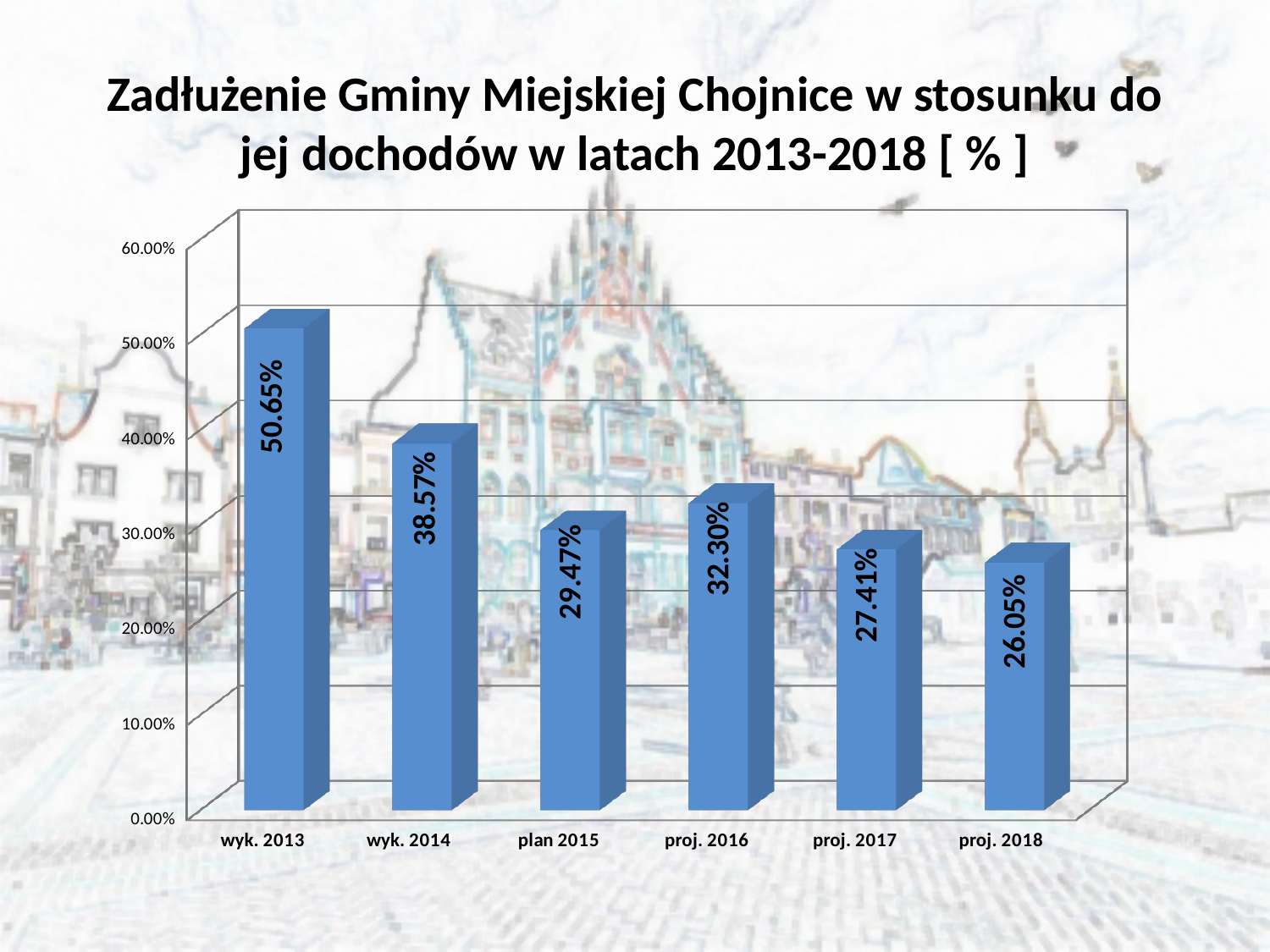
What is the value for proj. 2018? 26.05% What kind of chart is shown on the slide? bar chart Which is larger, the value for plan 2015 or the value for proj. 2016? proj. 2016 What is the value for wyk. 2013? 50.65% Is the value for wyk. 2014 greater or less than 40.00%? less What is the title of the chart? Zadłużenie Gminy Miejskiej Chojnice w stosunku do jej dochodów w latach 2013-2018 [ % ] What is the difference between the values for proj. 2016 and proj. 2017? 4.89% How many categories are shown on the x axis? 6 Which category has the lowest value? proj. 2018 What is the value for plan 2015? 29.47% What is the difference between the values for wyk. 2013 and wyk. 2014? 12.08% Which category has the highest value? wyk. 2013